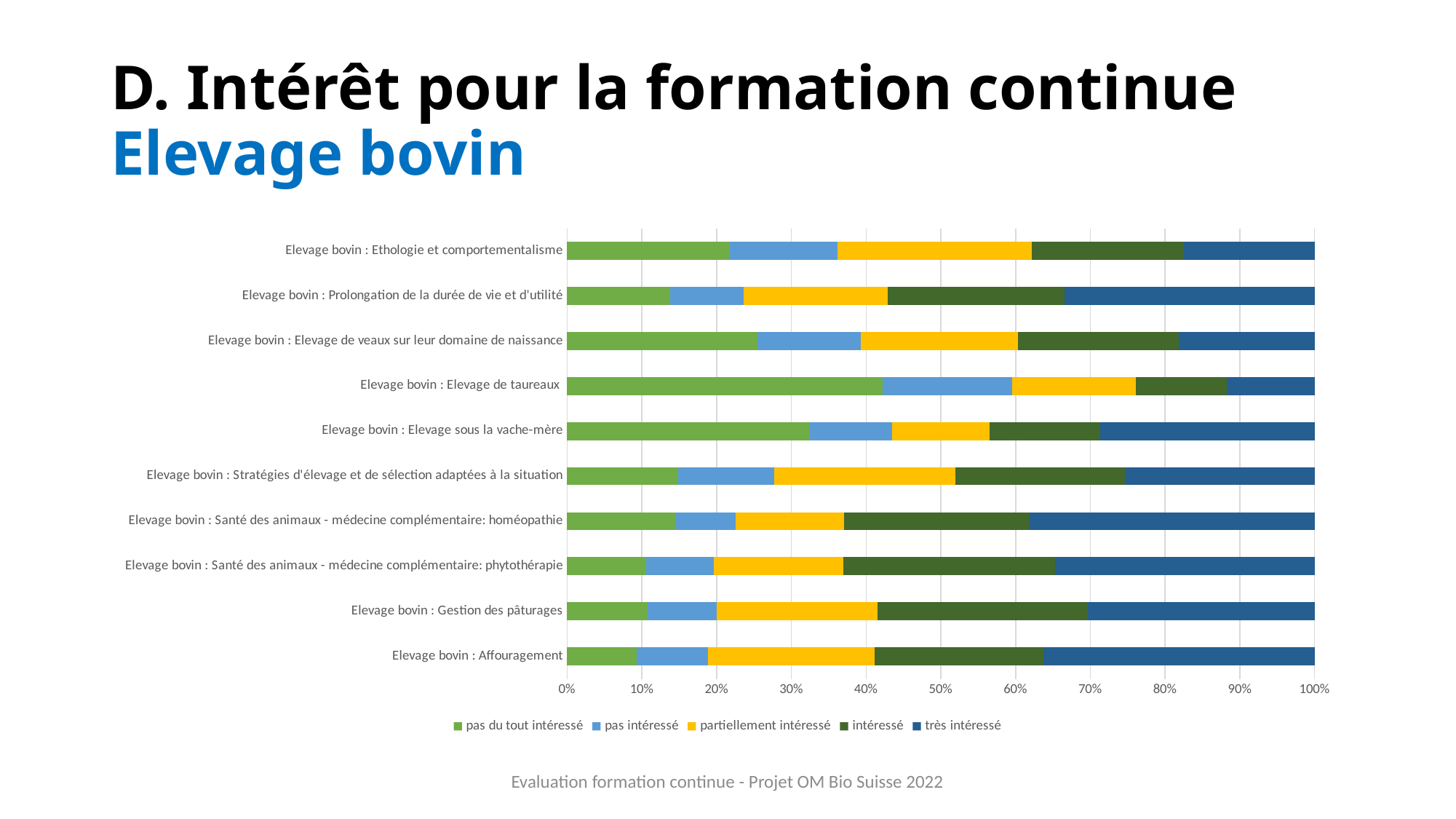
Is the 'pas du tout intéressé' share for 'Elevage bovin : Affouragement' greater or less than 20%? less Is the 'pas du tout intéressé' share for 'Elevage bovin : Elevage de taureaux' greater or less than 40%? greater What kind of chart is shown on the slide? Stacked bar chart What is the total of each stacked bar on the chart? 100% How many categories (training topics) are plotted on the chart? 10 Which category has the largest 'pas du tout intéressé' segment? Elevage bovin : Elevage de taureaux Which category has the smallest 'très intéressé' segment? Elevage bovin : Elevage de taureaux Which has the larger 'très intéressé' segment: 'Prolongation de la durée de vie et d'utilité' or 'Ethologie et comportementalisme'? Prolongation de la durée de vie et d'utilité Is the 'pas du tout intéressé' share for 'Elevage bovin : Elevage sous la vache-mère' greater or less than 20%? greater Which has the larger 'pas du tout intéressé' segment: 'Elevage de veaux sur leur domaine de naissance' or 'Prolongation de la durée de vie et d'utilité'? Elevage de veaux sur leur domaine de naissance How many series does the legend list? 5 Which colour represents the 'très intéressé' series in the legend? Dark blue